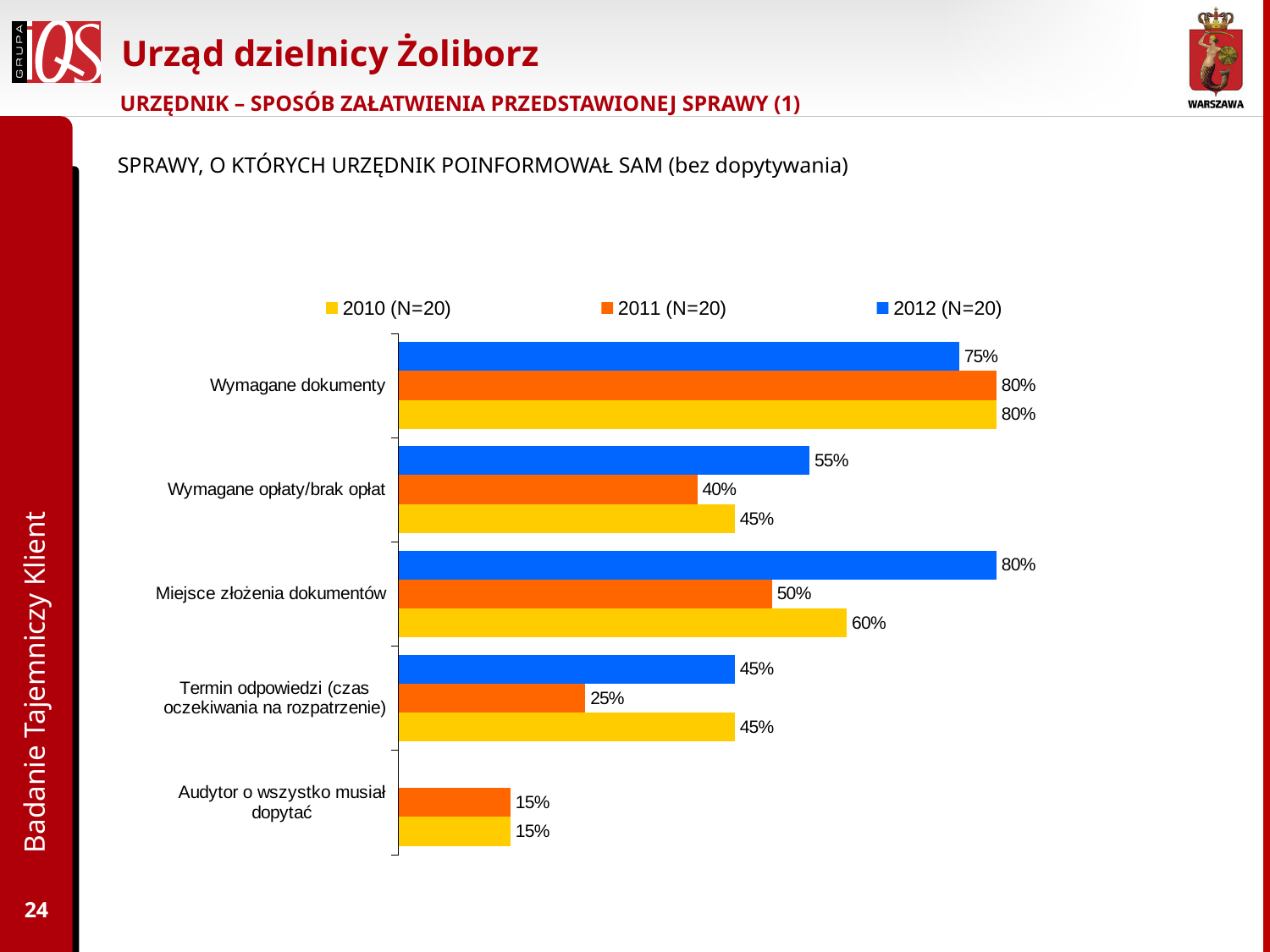
What is the value for Termin odpowiedzi (czas oczekiwania na rozpatrzenie) in the 2011 (N=20) series? 25% How many series does the legend list? 3 What is the value for Wymagane dokumenty in the 2012 (N=20) series? 75% Which is larger for Wymagane opłaty/brak opłat: the 2012 (N=20) value or the 2010 (N=20) value? 2012 (N=20) Which category has the highest value in the 2012 (N=20) series? Miejsce złożenia dokumentów What kind of chart is shown on the slide? Bar chart How many categories are shown on the chart? 5 What is the value for Wymagane opłaty/brak opłat in the 2011 (N=20) series? 40% What is the difference between the 2012 (N=20) and 2011 (N=20) values for Miejsce złożenia dokumentów? 30% Which category has the lowest value in the 2011 (N=20) series? Audytor o wszystko musiał dopytać What is the value for Miejsce złożenia dokumentów in the 2010 (N=20) series? 60% Which colour represents the 2012 (N=20) series in the chart? Blue